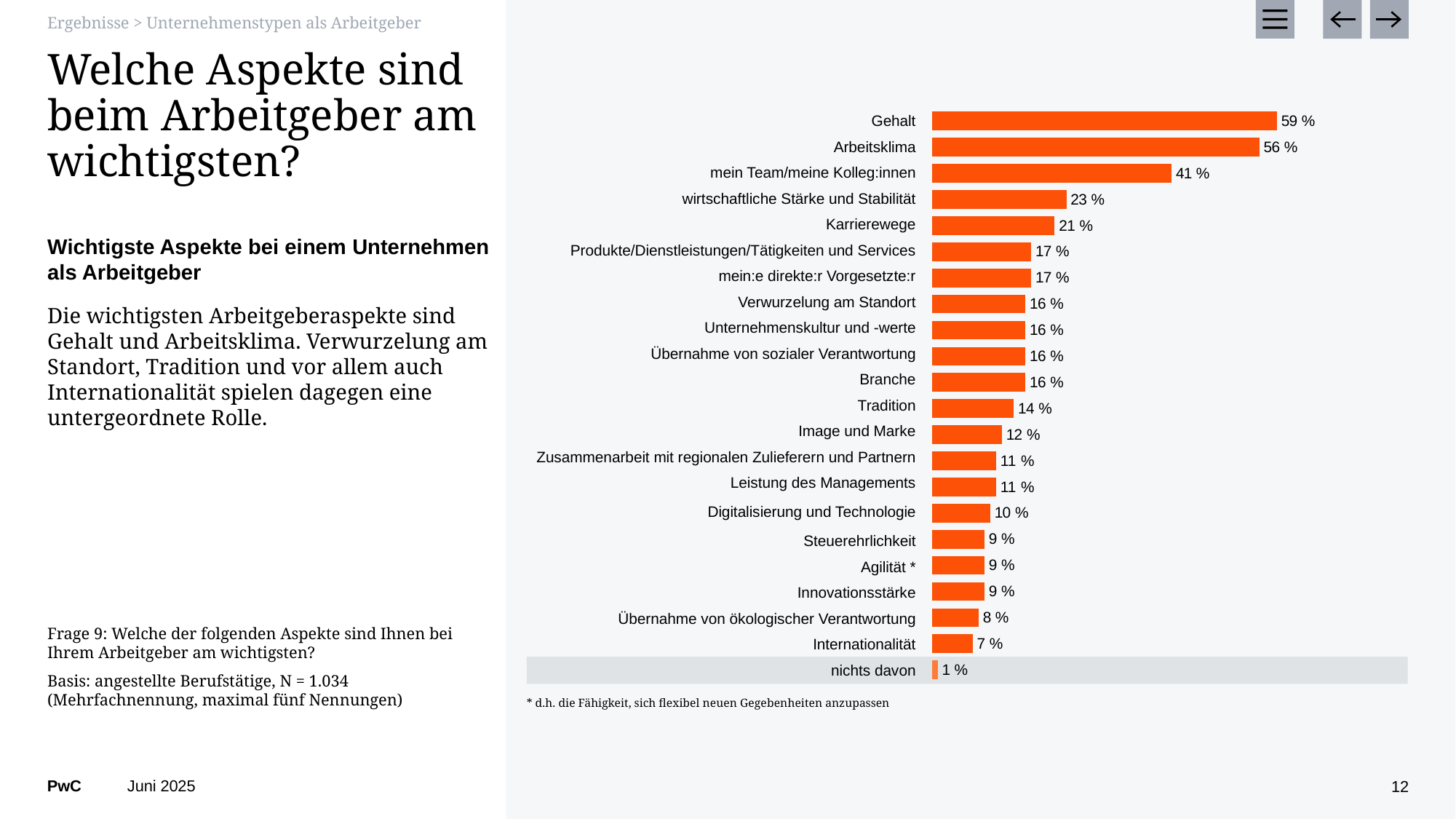
What is the difference between the values for mein Team/meine Kolleg:innen and wirtschaftliche Stärke und Stabilität? 18 % What kind of chart is shown on the slide? bar chart What is the value for Tradition? 14 % What colour are the bars in the chart? orange Which is larger, the value for Karrierewege or the value for Image und Marke? Karrierewege Which category has the highest value? Gehalt What is the value for Gehalt? 59 % What is the value for Arbeitsklima? 56 % How many categories are shown in the chart? 22 Which category has the lowest value? nichts davon What is the value for Internationalität? 7 % What is the difference between the values for Gehalt and Arbeitsklima? 3 %